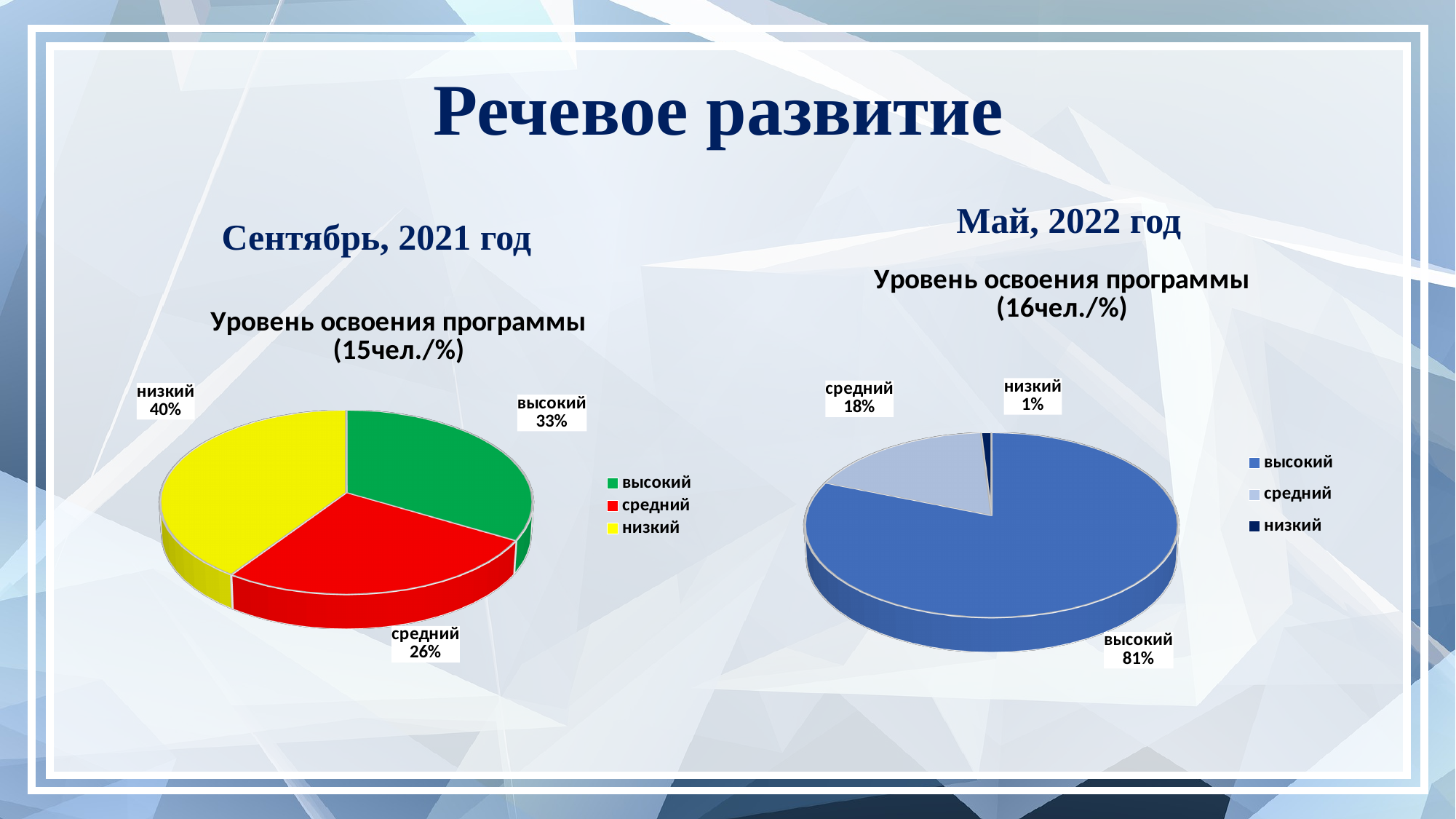
How many categories does the legend of the left pie chart (Сентябрь, 2021 год) list? 3 In the right pie chart (Май, 2022 год), which category has the smallest share? низкий In the left pie chart (Сентябрь, 2021 год), what is the share for высокий? 33% In the left pie chart (Сентябрь, 2021 год), which category has the smallest share? средний In the right pie chart (Май, 2022 год), what is the difference between the shares for высокий and средний? 63% Which is larger: the share for высокий in the left chart (Сентябрь, 2021 год) or in the right chart (Май, 2022 год)? Май, 2022 год In the right pie chart (Май, 2022 год), what is the share for высокий? 81% In the left pie chart (Сентябрь, 2021 год), what is the difference between the shares for низкий and средний? 14% In the right pie chart (Май, 2022 год), what is the share for низкий? 1% What type of chart is used on the right (Май, 2022 год)? Pie chart In the left pie chart (Сентябрь, 2021 год), which category has the largest share? низкий In the left pie chart (Сентябрь, 2021 год), what is the share for низкий? 40%